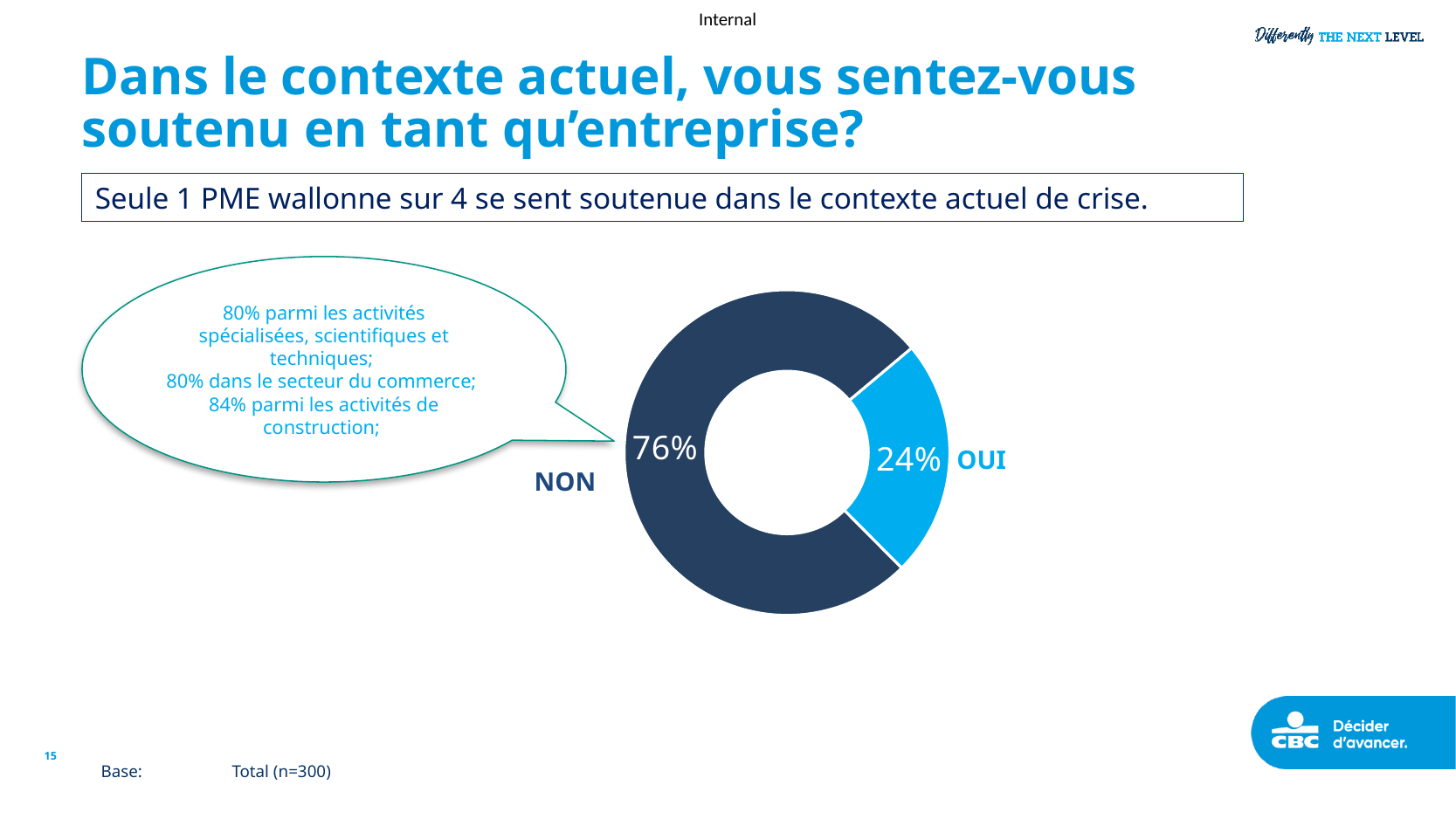
What percentage of respondents answered NON? 76% What is the base (sample size) stated for the chart? Total (n=300) What percentage of respondents answered OUI? 24% Which is larger, the share for OUI or the share for NON? NON What share of the chart does the OUI slice represent? 24% How many categories are shown in the chart? 2 Which response has the largest share of the chart? NON Which response has the smallest share of the chart? OUI What colour is the OUI slice of the chart? Light blue What kind of chart is shown on the slide? Doughnut (pie) chart What is the total of the two slices shown in the chart? 100% What is the difference in percentage points between NON and OUI? 52